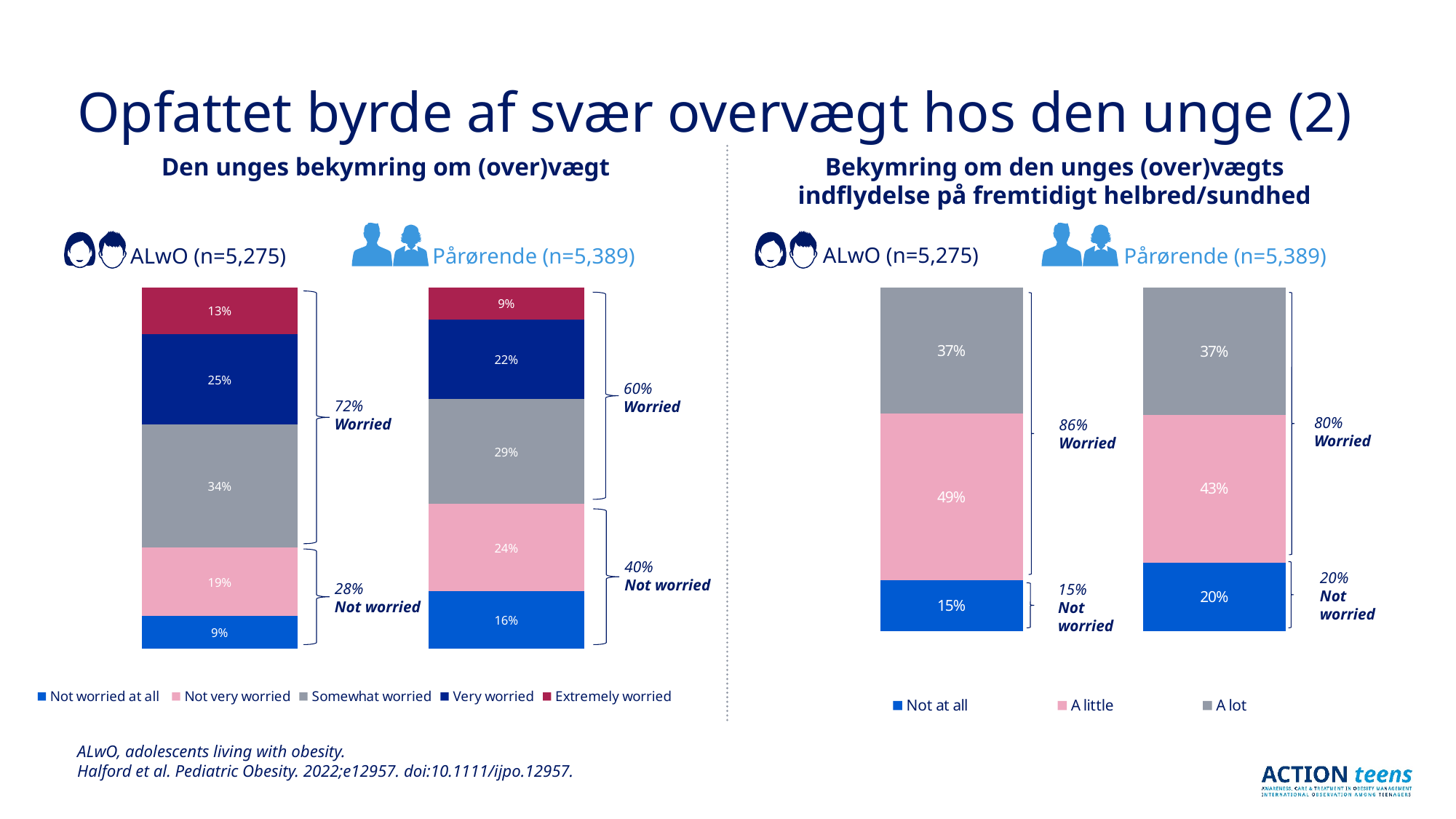
In the right chart 'Bekymring om den unges (over)vægts indflydelse på fremtidigt helbred/sundhed', what total percentage of Pårørende are labelled 'Worried'? 80% What kind of chart is used on the right side of the slide? Stacked bar chart In the left chart 'Den unges bekymring om (over)vægt', what total percentage of ALwO are labelled 'Worried'? 72% In the right chart 'Bekymring om den unges (over)vægts indflydelse på fremtidigt helbred/sundhed', which segment is the largest for ALwO? A little In the right chart 'Bekymring om den unges (over)vægts indflydelse på fremtidigt helbred/sundhed', what is the difference between the 'A little' share for ALwO and for Pårørende? 6% In the right chart 'Bekymring om den unges (over)vægts indflydelse på fremtidigt helbred/sundhed', what percentage of ALwO answered 'A little'? 49% In the left chart 'Den unges bekymring om (over)vægt', what percentage of ALwO are 'Extremely worried'? 13% In the left chart 'Den unges bekymring om (over)vægt', how many series does the legend list? 5 In the left chart 'Den unges bekymring om (over)vægt', which group has the larger 'Not worried at all' share, ALwO or Pårørende? Pårørende In the right chart 'Bekymring om den unges (over)vægts indflydelse på fremtidigt helbred/sundhed', what percentage of Pårørende answered 'Not at all'? 20% In the left chart 'Den unges bekymring om (over)vægt', what percentage of Pårørende are 'Somewhat worried'? 29% In the left chart 'Den unges bekymring om (over)vægt', what is the difference between the 'Very worried' share for ALwO and for Pårørende? 3%